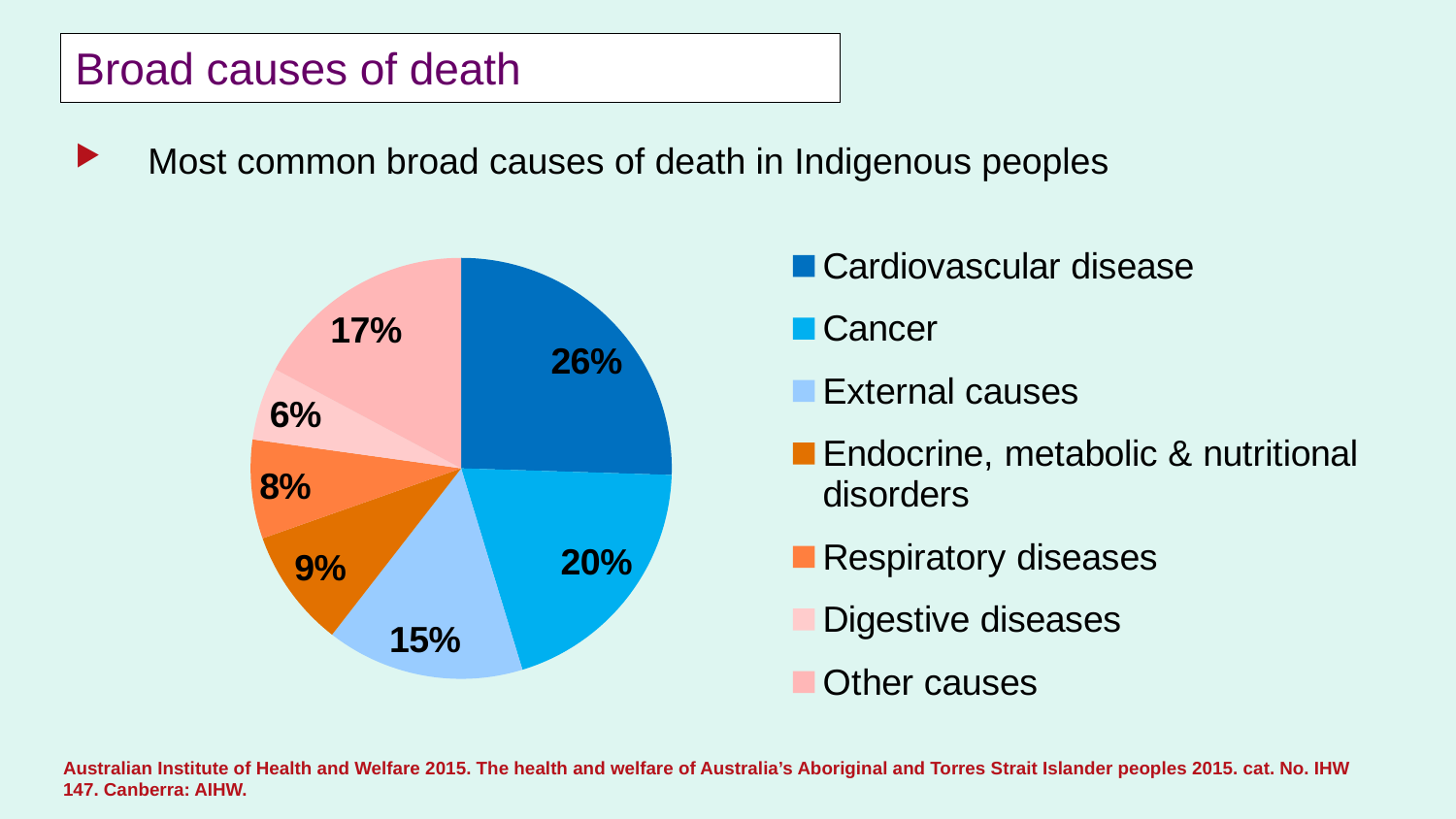
What share of the pie is external causes? 15% What share of the pie is other causes? 17% Which cause of death has the smallest share of the pie? Digestive diseases What percentage of deaths is attributed to cardiovascular disease? 26% What percentage is shown for endocrine, metabolic & nutritional disorders? 9% What percentage of deaths is attributed to cancer? 20% Which is larger, the share for respiratory diseases or the share for external causes? External causes Which cause of death has the largest share of the pie? Cardiovascular disease What percentage is shown for respiratory diseases? 8% What percentage is shown for digestive diseases? 6% What is the difference in percentage points between cardiovascular disease and cancer? 6 How many categories does the legend list? 7